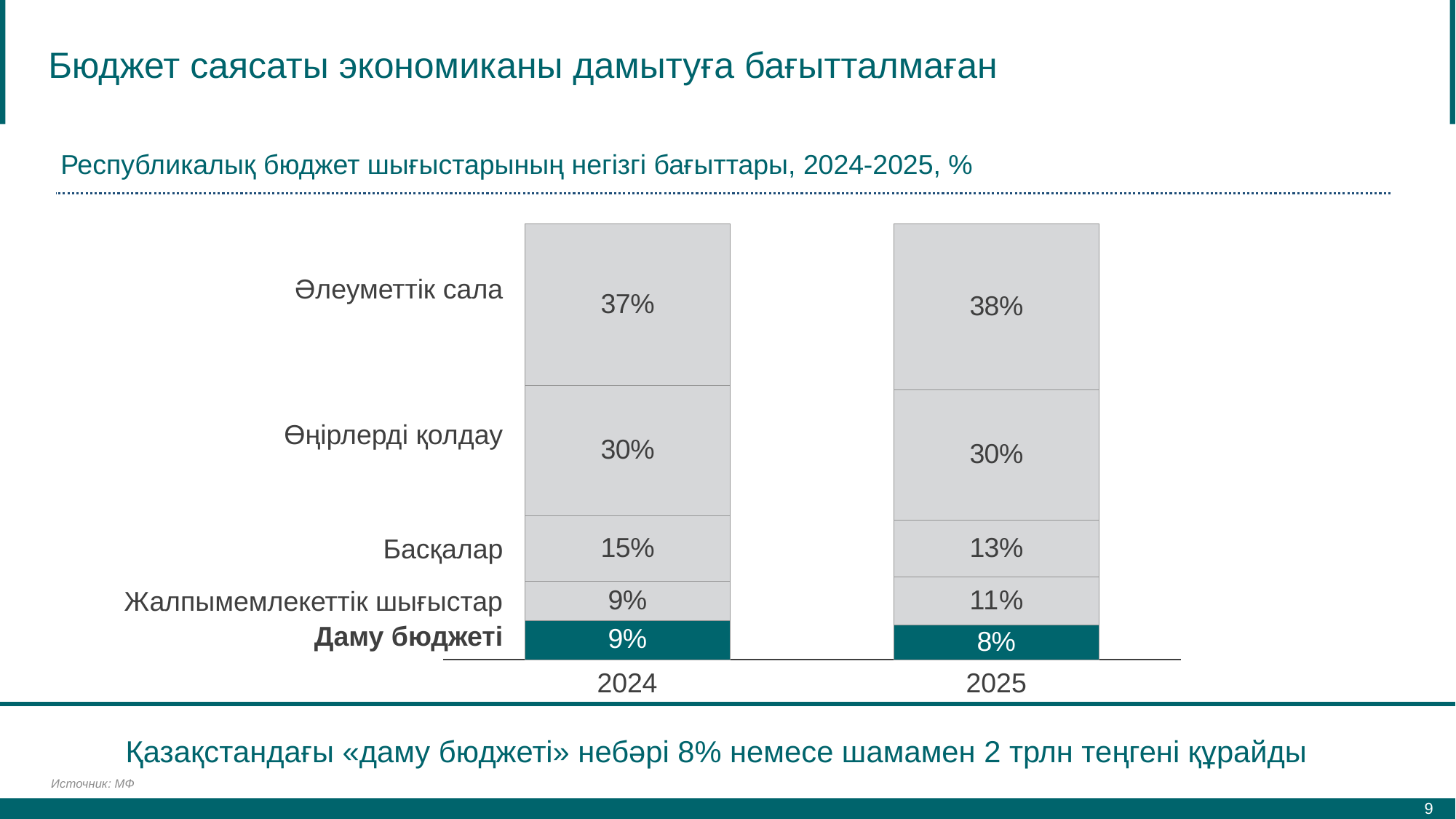
What is the value for Даму бюджеті in 2025? 8% What is the value for Басқалар in 2024? 15% What kind of chart is shown on the slide? Stacked bar chart What is the total of the 2024 stacked bar? 100% Which segment is the largest in the 2025 bar? Әлеуметтік сала What is the value for Жалпымемлекеттік шығыстар in 2025? 11% What is the difference between the Басқалар values for 2024 and 2025? 2% Which segment is the smallest in the 2025 bar? Даму бюджеті What is the value for Әлеуметтік сала in 2024? 37% Which is larger: Жалпымемлекеттік шығыстар in 2025 or Даму бюджеті in 2025? Жалпымемлекеттік шығыстар How many segments make up each stacked bar? 5 How many years (bars) are shown on the x axis? 2